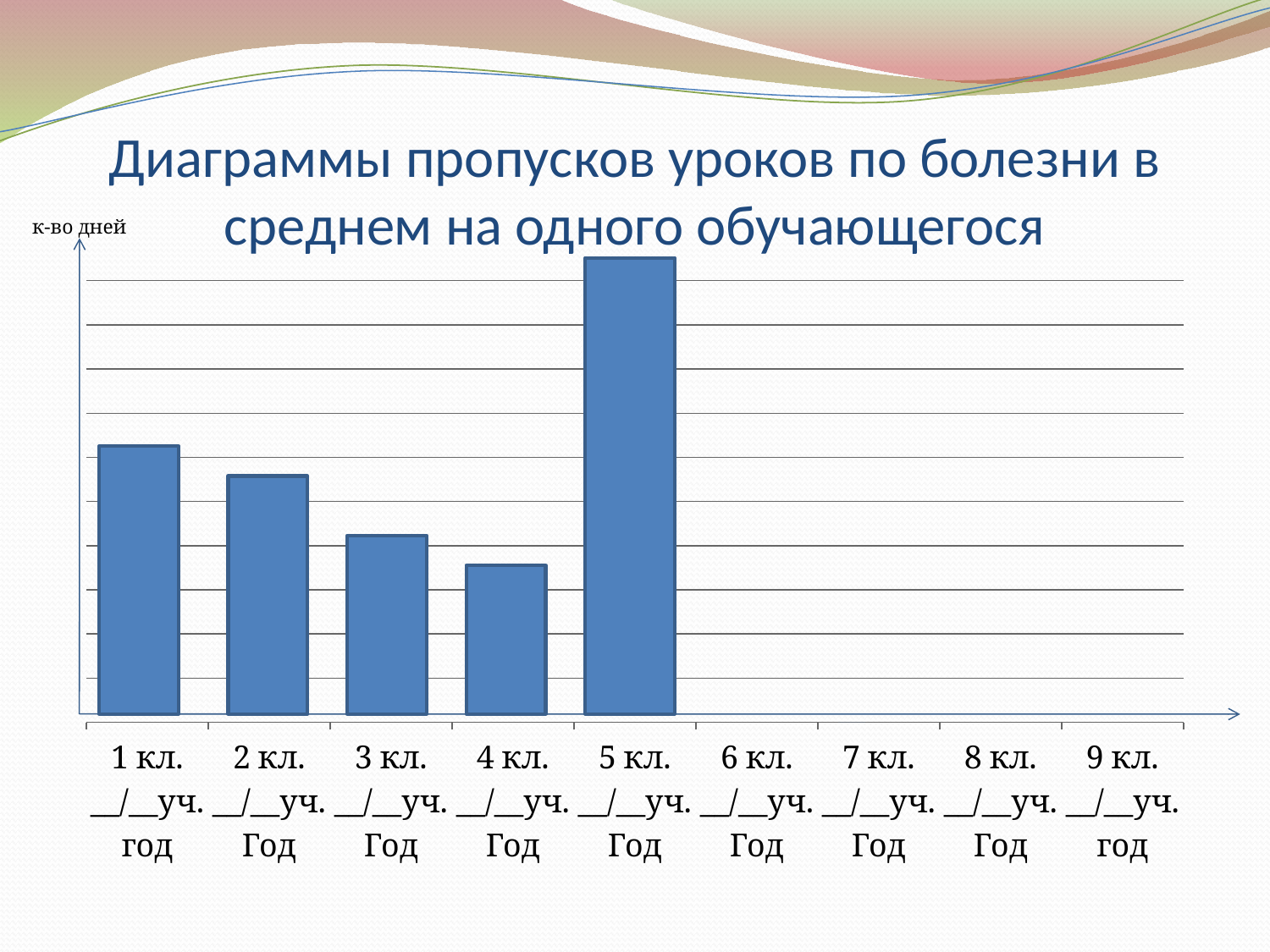
Which bar is taller, 5 кл. or 1 кл.? 5 кл. Which bar is taller, 3 кл. or 4 кл.? 3 кл. Which class has the tallest bar in the chart? 5 кл. How many class categories are labelled on the x axis? 9 Among the classes with a plotted bar, which class has the shortest bar? 4 кл. How many bars are actually plotted in the chart? 5 Do the bar heights rise or fall from 1 кл. to 4 кл.? fall What kind of chart is shown on the slide? bar chart What is the label on the vertical axis of the chart? к-во дней Which bar is taller, 1 кл. or 2 кл.? 1 кл. What is the title of the chart on the slide? Диаграммы пропусков уроков по болезни в среднем на одного обучающегося